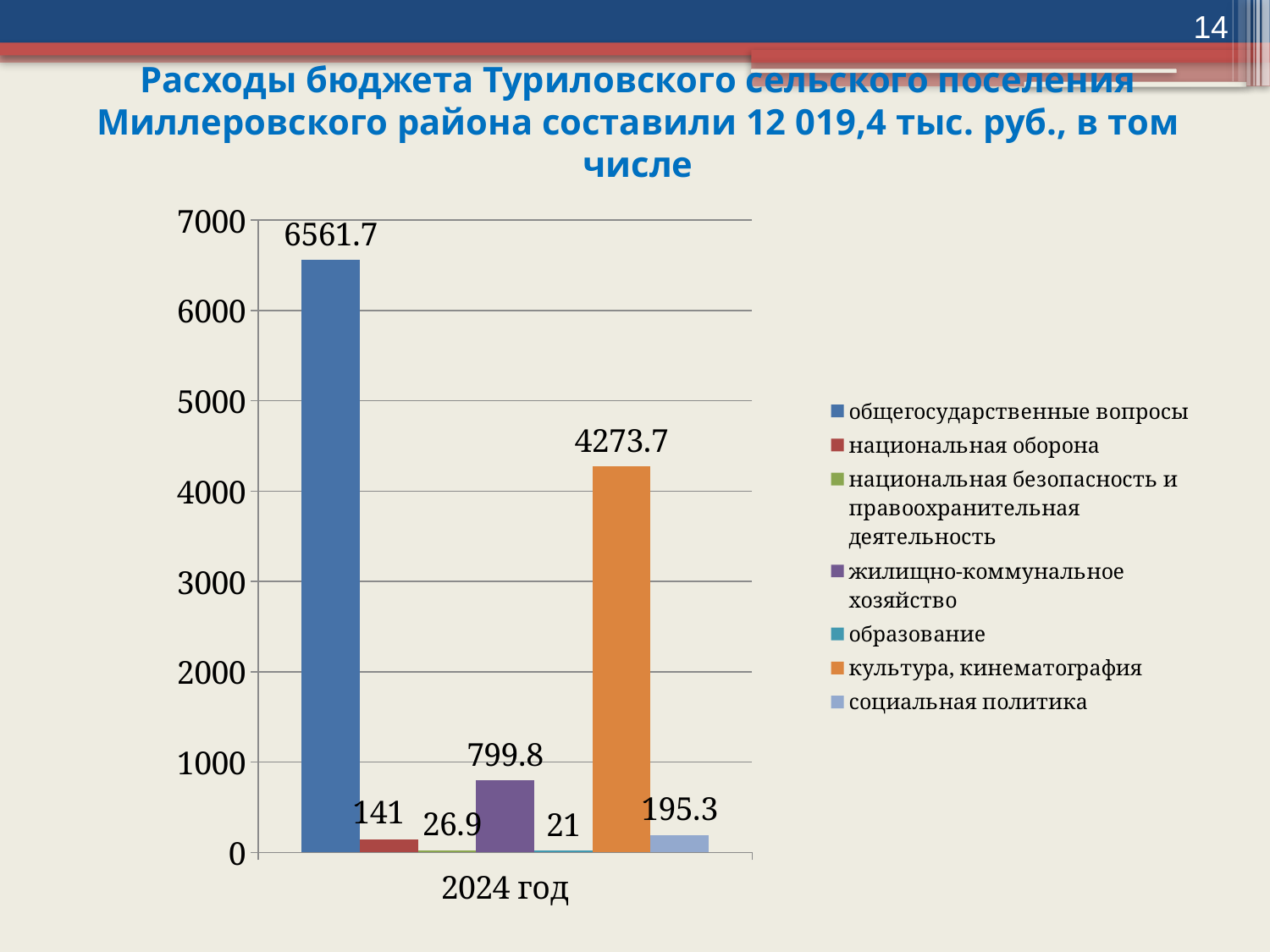
What is the value for жилищно-коммунальное хозяйство in 2024 год? 799.8 What is the difference between the values for общегосударственные вопросы and культура, кинематография? 2288 What kind of chart is shown on the slide? bar chart Which series has the lowest value in 2024 год? образование What is the value for культура, кинематография in 2024 год? 4273.7 How many series does the legend list? 7 What is the value for образование in 2024 год? 21 What is the category label shown on the x axis? 2024 год What is the value for общегосударственные вопросы in 2024 год? 6561.7 Which series has the highest value in 2024 год? общегосударственные вопросы Which is larger: the value for социальная политика or the value for национальная оборона? социальная политика Is the value for культура, кинематография greater or less than 4000? greater